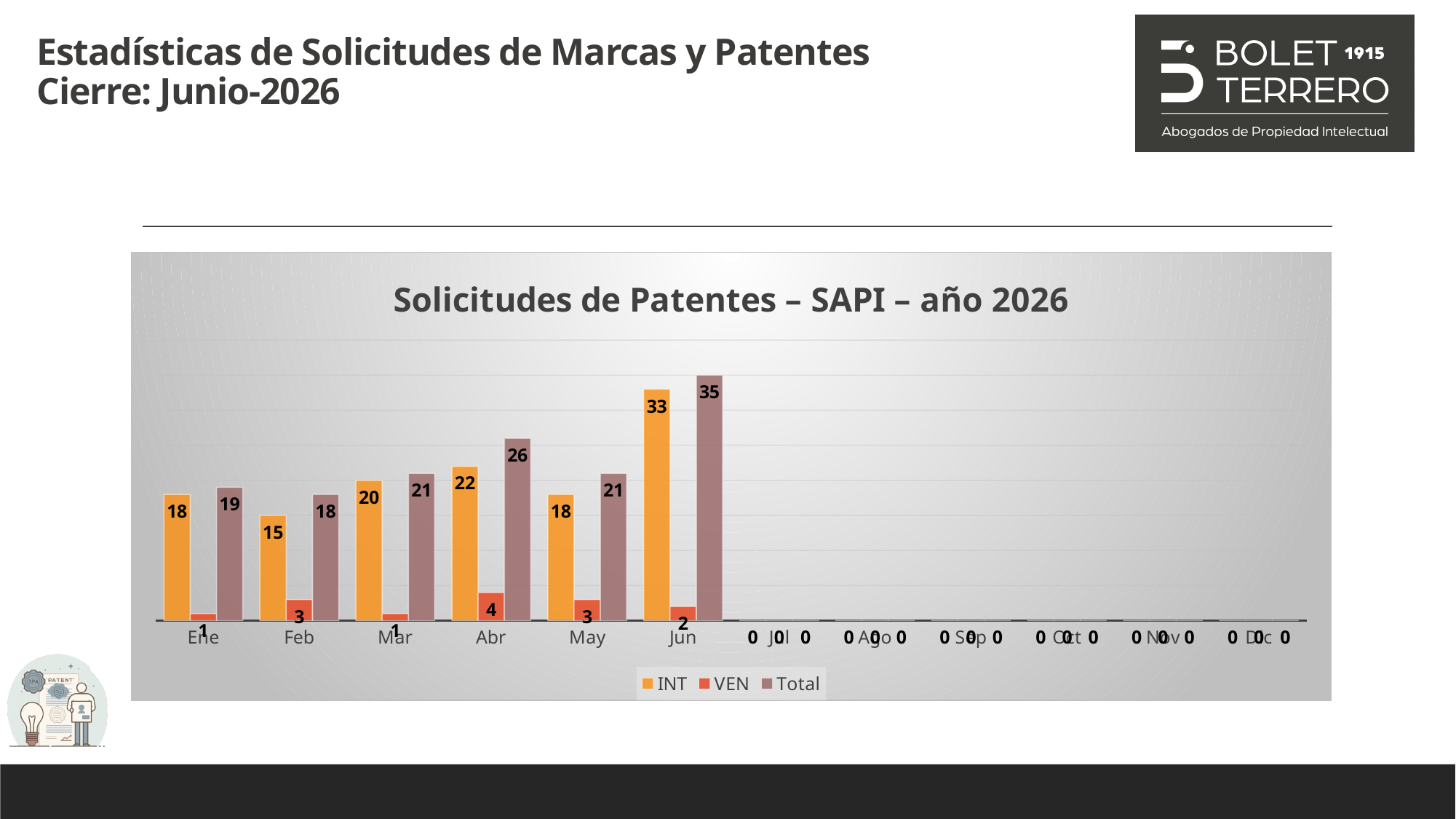
What is the VEN value for Abr? 4 What type of chart is shown on the slide? bar chart How many series does the legend list? 3 What is the Total value for Jul? 0 Which month has the highest Total value? Jun Which is larger, the INT value for Mar or the INT value for May? Mar Among the months Ene to Jun, which has the lowest INT value? Feb How many months are shown on the x axis of the chart? 12 What is the difference between the Total values for Jun and Abr? 9 What is the INT value for Jun? 33 What is the title of the chart? Solicitudes de Patentes – SAPI – año 2026 What is the Total value for Mar? 21